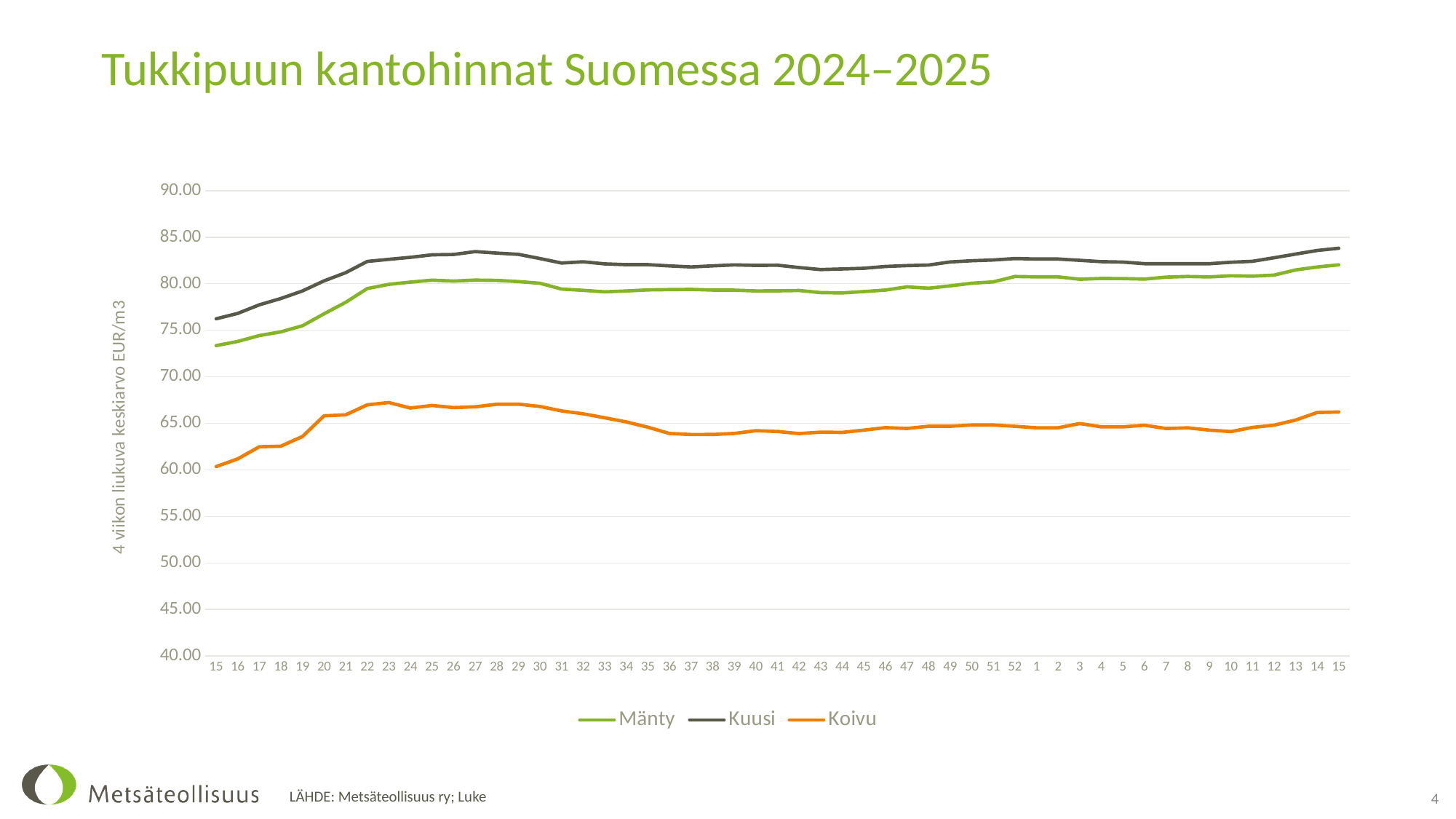
Does the Mänty line rise or fall from week 15 to week 22? rise Which series has the highest values throughout the chart? Kuusi What kind of chart is shown on the slide? line chart Is the value for Koivu at week 23 greater or less than 65? greater Is the value for Koivu at week 44 greater or less than 65? less Which series has the lowest values throughout the chart? Koivu Is the value for Kuusi at week 27 greater or less than 85? less At week 30, which is larger, the value for Kuusi or the value for Mänty? Kuusi How many series does the legend list? 3 What is the title of the chart? Tukkipuun kantohinnat Suomessa 2024–2025